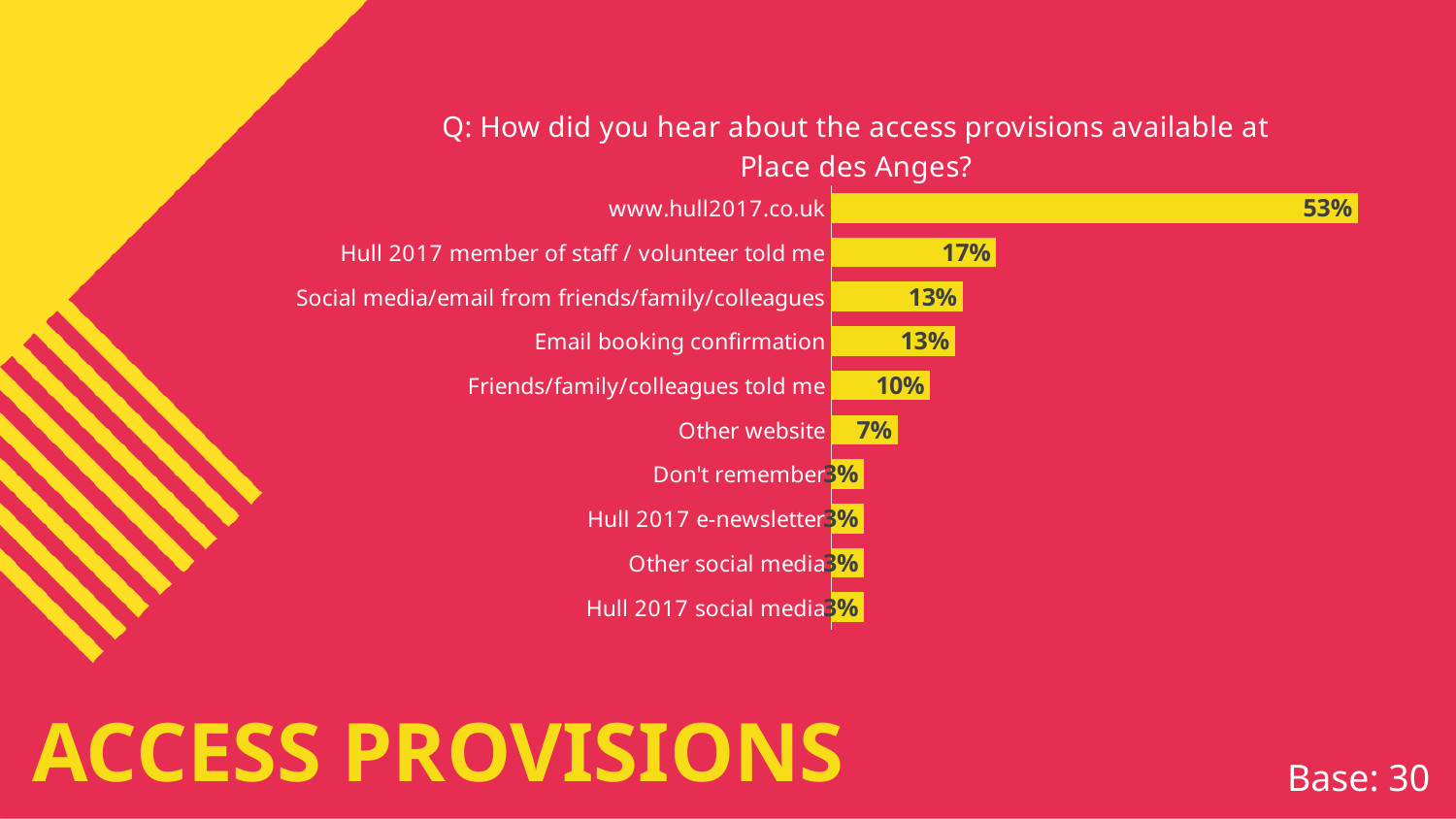
What is the difference between the values for www.hull2017.co.uk and 'Hull 2017 member of staff / volunteer told me'? 36% What is the value for 'Email booking confirmation'? 13% What is the difference between 'Friends/family/colleagues told me' and 'Other website'? 3% What is the value for 'Other website'? 7% What kind of chart is shown on the slide? Bar chart What is the value for 'Hull 2017 e-newsletter'? 3% Which is larger: the value for 'Social media/email from friends/family/colleagues' or the value for 'Friends/family/colleagues told me'? Social media/email from friends/family/colleagues What percentage of respondents heard about the access provisions via www.hull2017.co.uk? 53% How many categories are shown in the chart? 10 What is the value for 'Hull 2017 member of staff / volunteer told me'? 17% Which category has the highest value in the chart? www.hull2017.co.uk What is the base (number of respondents) shown on the slide? 30